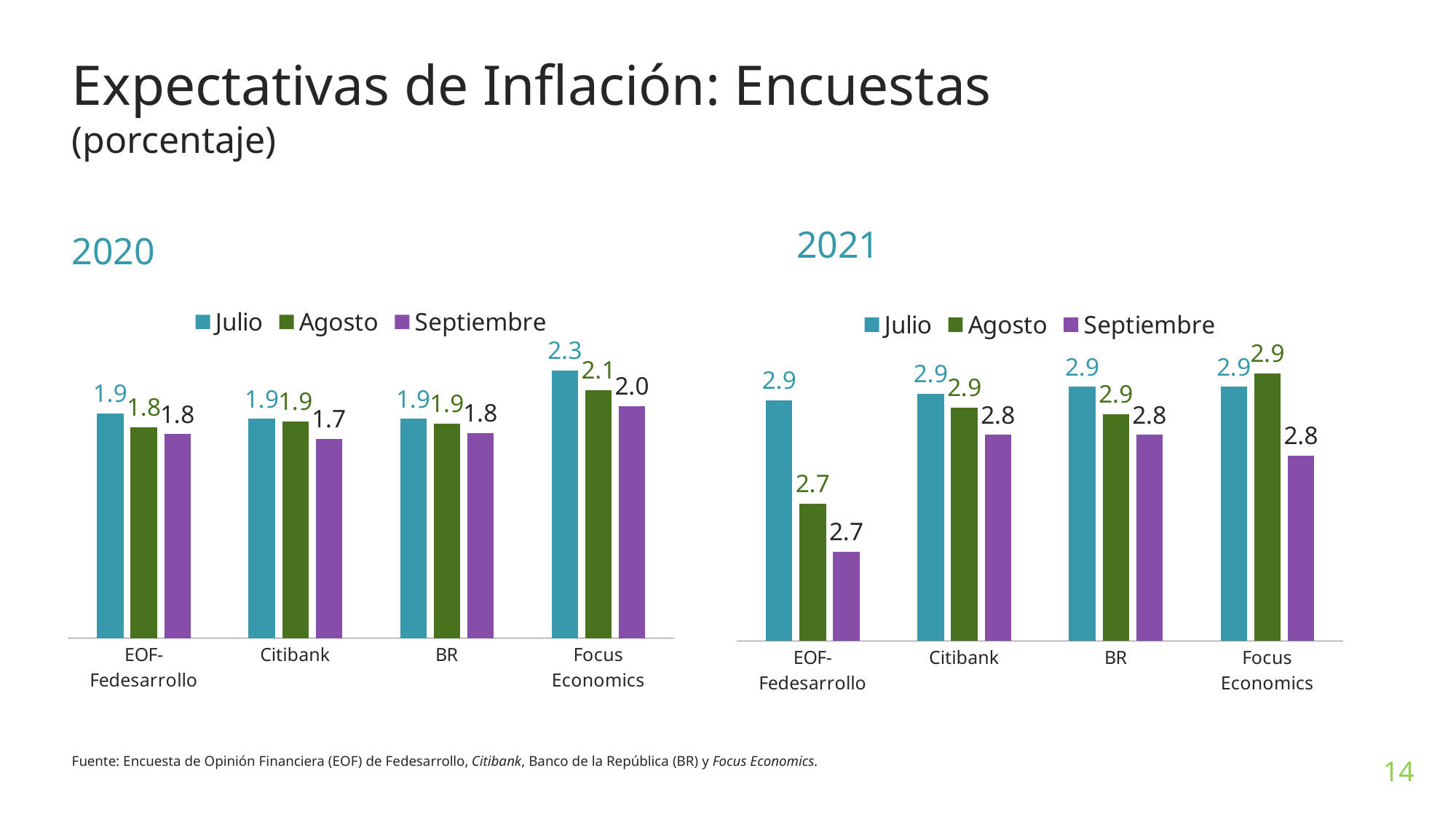
How many categories are shown on the x axis of the 2020 chart? 4 In the 2021 chart, which category has the lowest Septiembre value? EOF-Fedesarrollo In the 2021 chart, what is the difference between the Julio and Agosto values for EOF-Fedesarrollo? 0.2 What kind of chart is the 2020 chart? Bar chart In the 2021 chart, which is larger: the Agosto value for Focus Economics or the Agosto value for EOF-Fedesarrollo? Focus Economics In the 2020 chart, what is the Septiembre value for Citibank? 1.7 In the 2020 chart, which category has the highest Julio value? Focus Economics In the 2020 chart, what is the Julio value for Focus Economics? 2.3 In the 2021 chart, what is the Agosto value for BR? 2.9 In the 2021 chart, what is the Septiembre value for EOF-Fedesarrollo? 2.7 In the 2020 chart, what is the difference between the Julio and Septiembre values for Focus Economics? 0.3 How many series does the legend of the 2021 chart list? 3